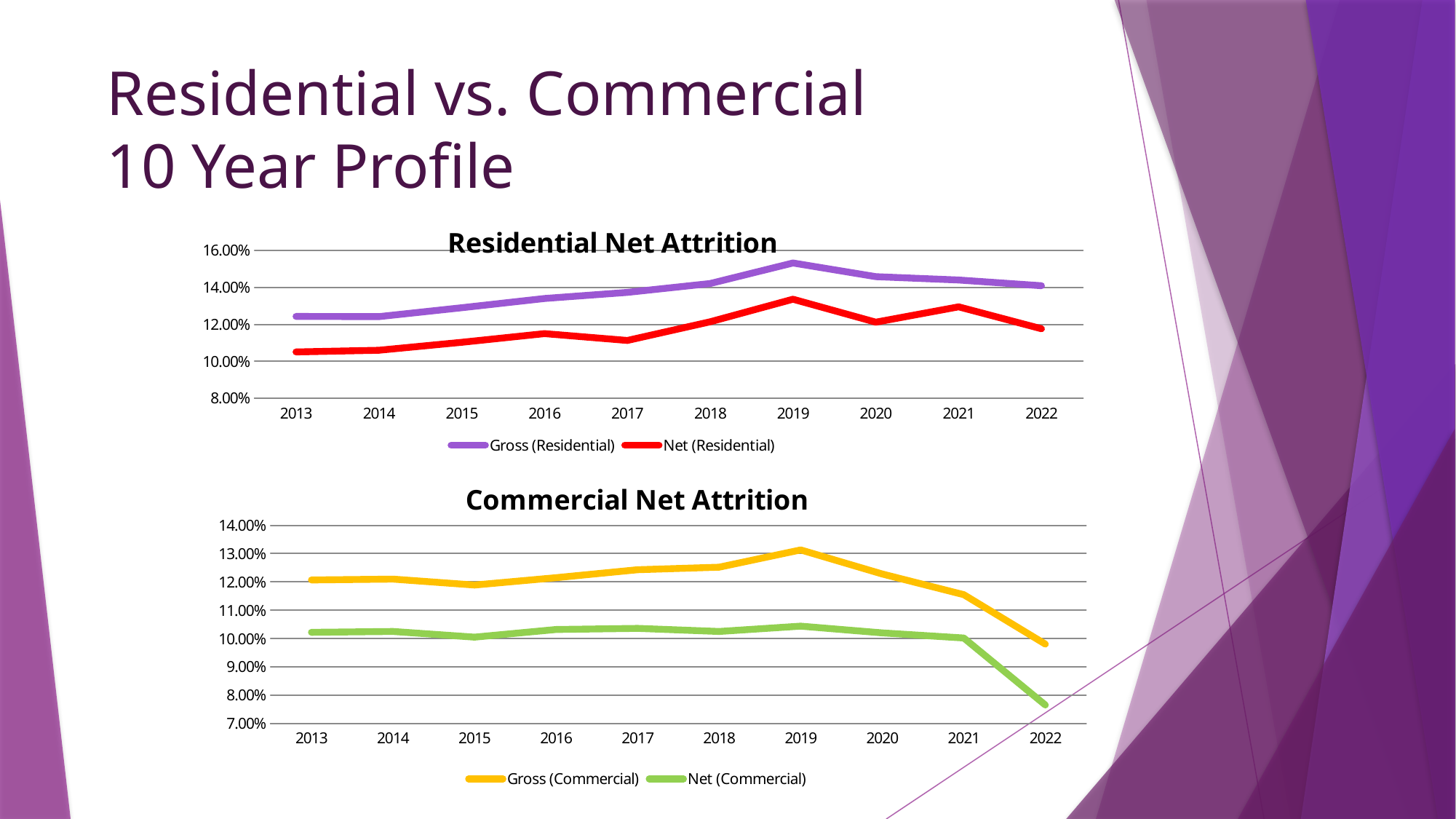
In the Commercial Net Attrition chart, in which year is Gross (Commercial) highest? 2019 In the Commercial Net Attrition chart, is the value for Net (Commercial) in 2022 greater or less than 8.00%? less How many years are plotted on the x axis of the Residential Net Attrition chart? 10 In the Commercial Net Attrition chart, which series is higher in 2022, Gross (Commercial) or Net (Commercial)? Gross (Commercial) What kind of chart is the Residential Net Attrition chart? line chart In the Commercial Net Attrition chart, in which year is Net (Commercial) lowest? 2022 In the Residential Net Attrition chart, is the value for Gross (Residential) in 2019 greater or less than 14.00%? greater In the Residential Net Attrition chart, in which year does Gross (Residential) reach its highest value? 2019 How many series does the legend of the Commercial Net Attrition chart list? 2 In the Residential Net Attrition chart, in which year does Net (Residential) reach its highest value? 2019 What colour is the Net (Residential) line in the Residential Net Attrition chart? red In the Commercial Net Attrition chart, does Net (Commercial) rise or fall from 2021 to 2022? fall